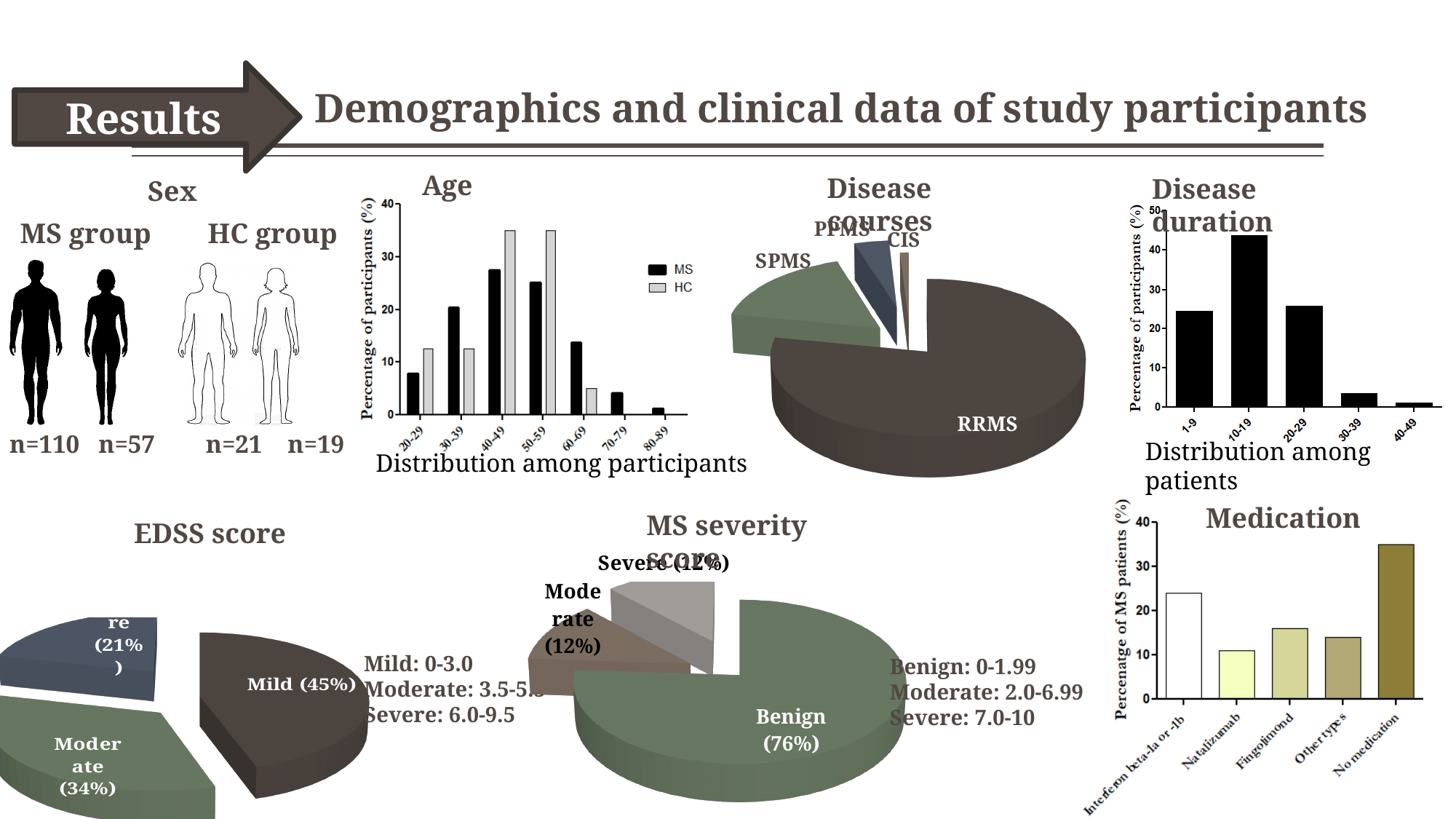
How many age groups are shown on the x axis of the Age chart? 7 In the Age chart, is the HC value for the 40-49 age group greater or less than 30? greater In the MS severity score pie chart, what share of patients are Benign? 76% In the EDSS score pie chart, what percentage of patients are in the Mild category? 45% In the Age chart, is the MS value for the 20-29 age group greater or less than 10? less How many series does the legend of the Age chart list? 2 In the Disease courses pie chart, which disease course has the largest slice? RRMS What kind of chart is the Age chart? bar chart In the Disease duration chart, which duration category has the lowest percentage of participants? 40-49 In the Disease duration chart, which duration category has the highest percentage of participants? 10-19 In the Medication chart, which medication category has the highest percentage of MS patients? No medication In the EDSS score pie chart, what is the difference in percentage points between the Mild and Moderate slices? 11